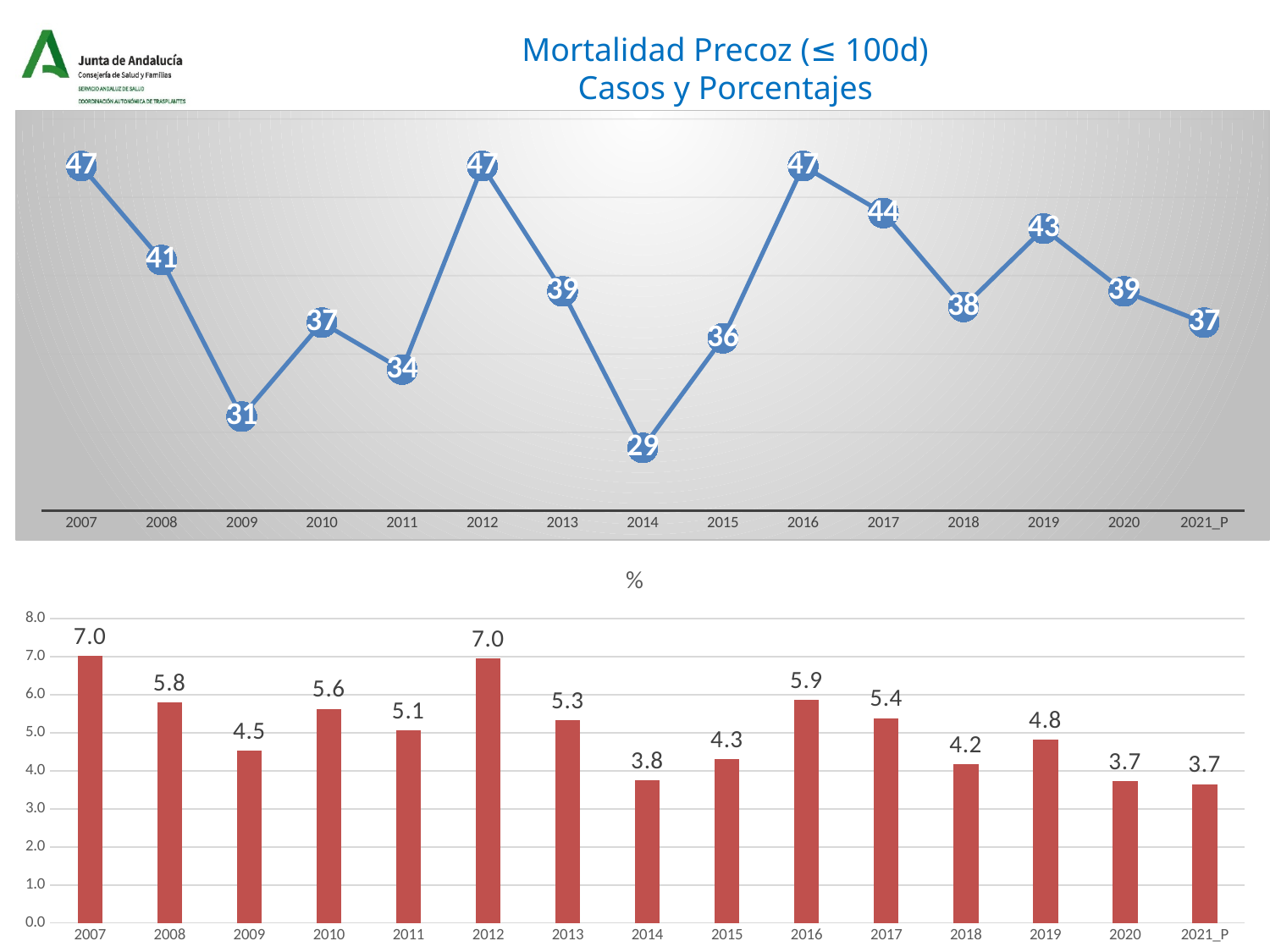
In the bottom bar chart (%), what is the difference between the values for 2007 and 2014? 3.2 In the bottom bar chart (%), what is the value for 2009? 4.5 In the top line chart, which year has the lowest value? 2014 What kind of chart is the bottom chart on the slide? Bar chart In the top line chart, which is larger, the value for 2009 or the value for 2011? 2011 What kind of chart is the top chart on the slide? Line chart In the top line chart, what is the value for 2014? 29 In the top line chart, what is the value for 2017? 44 In the bottom bar chart (%), what is the value for 2016? 5.9 In the top line chart, how many years are plotted along the x axis? 15 In the bottom bar chart (%), which is larger, the value for 2018 or the value for 2019? 2019 In the top line chart, what is the difference between the values for 2012 and 2013? 8